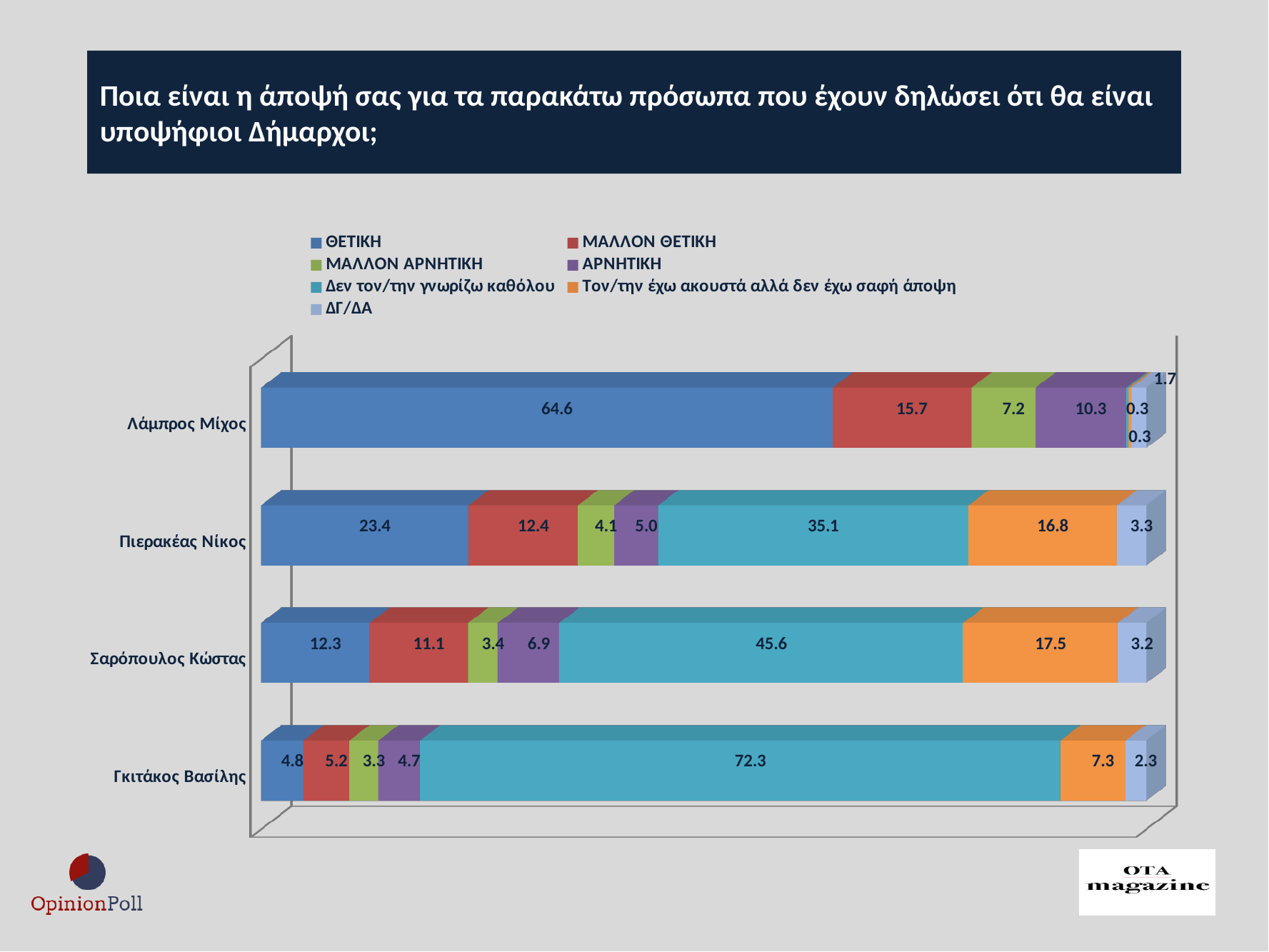
What is the difference between the ΘΕΤΙΚΗ values of Λάμπρος Μίχος and Πιερακέας Νίκος? 41.2 Who has the larger ΑΡΝΗΤΙΚΗ value, Σαρόπουλος Κώστας or Πιερακέας Νίκος? Σαρόπουλος Κώστας What is the difference between the 'Δεν τον/την γνωρίζω καθόλου' values of Σαρόπουλος Κώστας and Πιερακέας Νίκος? 10.5 What is the 'Τον/την έχω ακουστά αλλά δεν έχω σαφή άποψη' value for Σαρόπουλος Κώστας? 17.5 Which candidate has the lowest ΘΕΤΙΚΗ value? Γκιτάκος Βασίλης How many candidates are shown in the chart? 4 What kind of chart is shown on the slide? Stacked bar chart How many series does the legend list? 7 What is the ΔΓ/ΔΑ value for Πιερακέας Νίκος? 3.3 What is the 'Δεν τον/την γνωρίζω καθόλου' value for Γκιτάκος Βασίλης? 72.3 What is the ΘΕΤΙΚΗ value for Λάμπρος Μίχος? 64.6 Which candidate has the highest ΘΕΤΙΚΗ value? Λάμπρος Μίχος